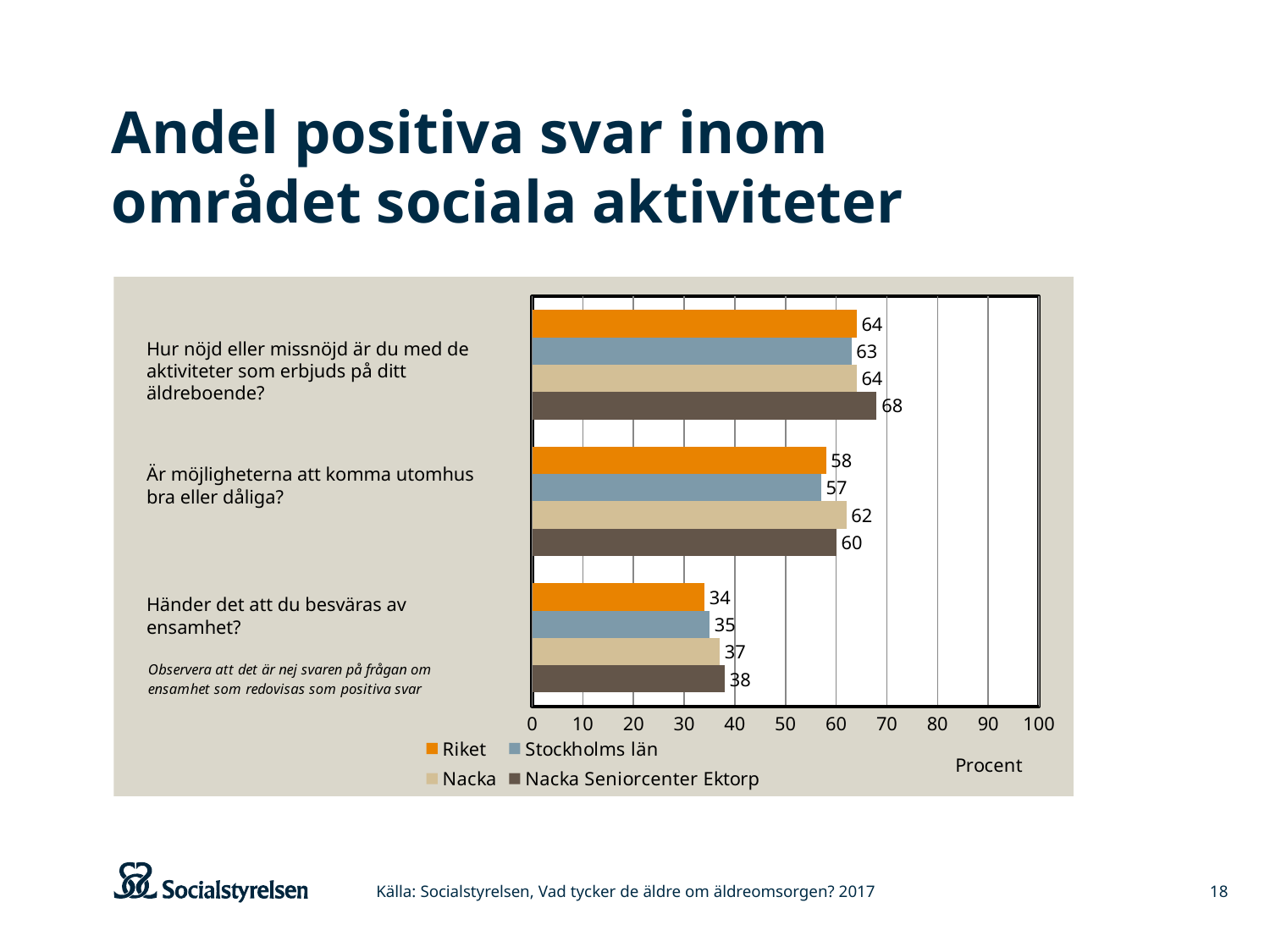
Is the value for Nacka for the question "Är möjligheterna att komma utomhus bra eller dåliga?" greater or less than 50? greater Which series has the lowest value for the question "Händer det att du besväras av ensamhet?"? Riket What is the value for Nacka Seniorcenter Ektorp for the question "Hur nöjd eller missnöjd är du med de aktiviteter som erbjuds på ditt äldreboende?"? 68 What type of chart is shown on the slide? bar chart What is the value for Stockholms län for the question "Är möjligheterna att komma utomhus bra eller dåliga?"? 57 Which series has the highest value for the question "Hur nöjd eller missnöjd är du med de aktiviteter som erbjuds på ditt äldreboende?"? Nacka Seniorcenter Ektorp How many series does the legend list? 4 How many question categories are plotted on the chart? 3 What is the difference between the Nacka value and the Riket value for the question "Är möjligheterna att komma utomhus bra eller dåliga?"? 4 What is the label of the x axis? Procent What is the value for Riket for the question "Händer det att du besväras av ensamhet?"? 34 For the question "Händer det att du besväras av ensamhet?", which is larger: the value for Nacka or the value for Nacka Seniorcenter Ektorp? Nacka Seniorcenter Ektorp